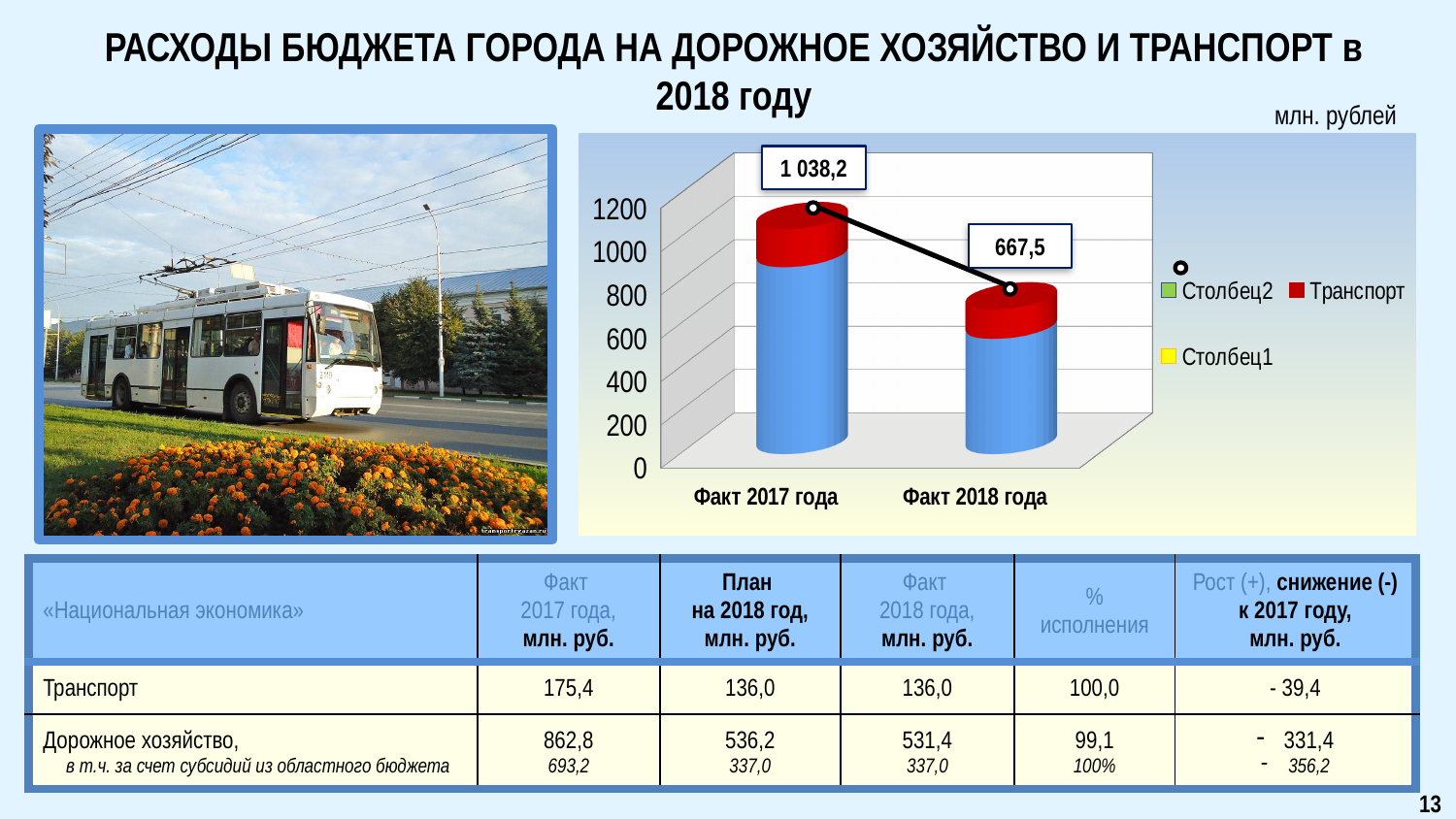
How many categories are shown on the x axis of the chart? 2 What kind of chart is shown on the slide? bar chart Which is larger, the value for Факт 2017 года or for Факт 2018 года? Факт 2017 года What is the value shown for Факт 2018 года? 667,5 Do the values rise or fall from Факт 2017 года to Факт 2018 года? fall What is the difference between the values for Факт 2017 года and Факт 2018 года? 370,7 Is the value for Факт 2018 года greater or less than 800? less What is the value shown for Факт 2017 года? 1 038,2 Which category has the highest value? Факт 2017 года Is the value for Факт 2017 года greater or less than 1000? greater How many series does the chart legend list? 3 Which category has the lowest value? Факт 2018 года